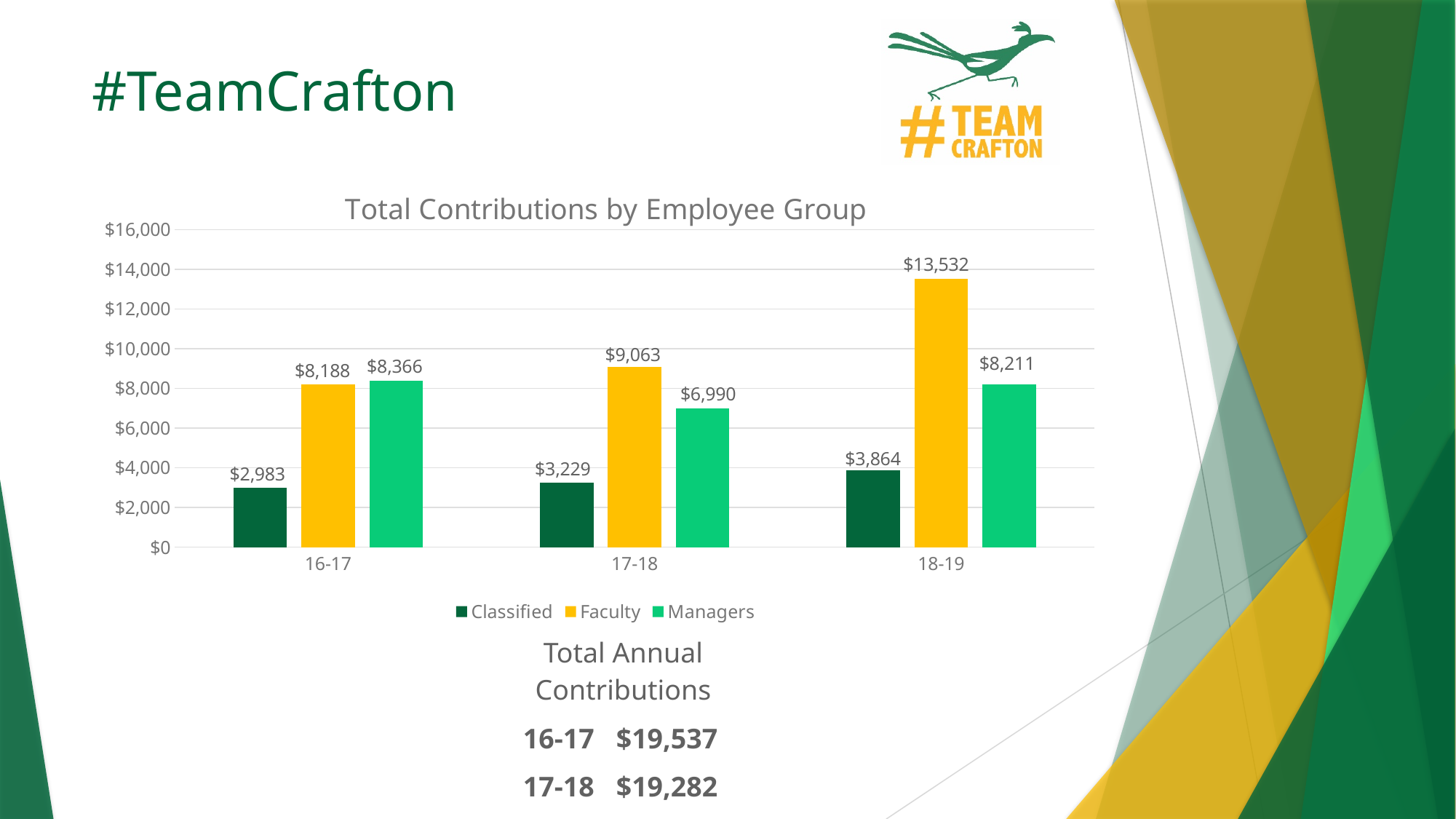
What is the Managers contribution for 17-18? $6,990 Do the Classified contributions rise or fall from 16-17 to 18-19? Rise What is the Faculty contribution for 18-19? $13,532 Which year has the highest Faculty contribution? 18-19 How many year categories are shown on the x axis? 3 How many series does the legend list? 3 In 16-17, which is larger: the Faculty contribution or the Managers contribution? Managers What is the title of the chart? Total Contributions by Employee Group Which year has the lowest Classified contribution? 16-17 What is the Classified contribution for 16-17? $2,983 What kind of chart is shown on the slide? Bar chart What is the difference between the Faculty and Classified contributions in 17-18? $5,834